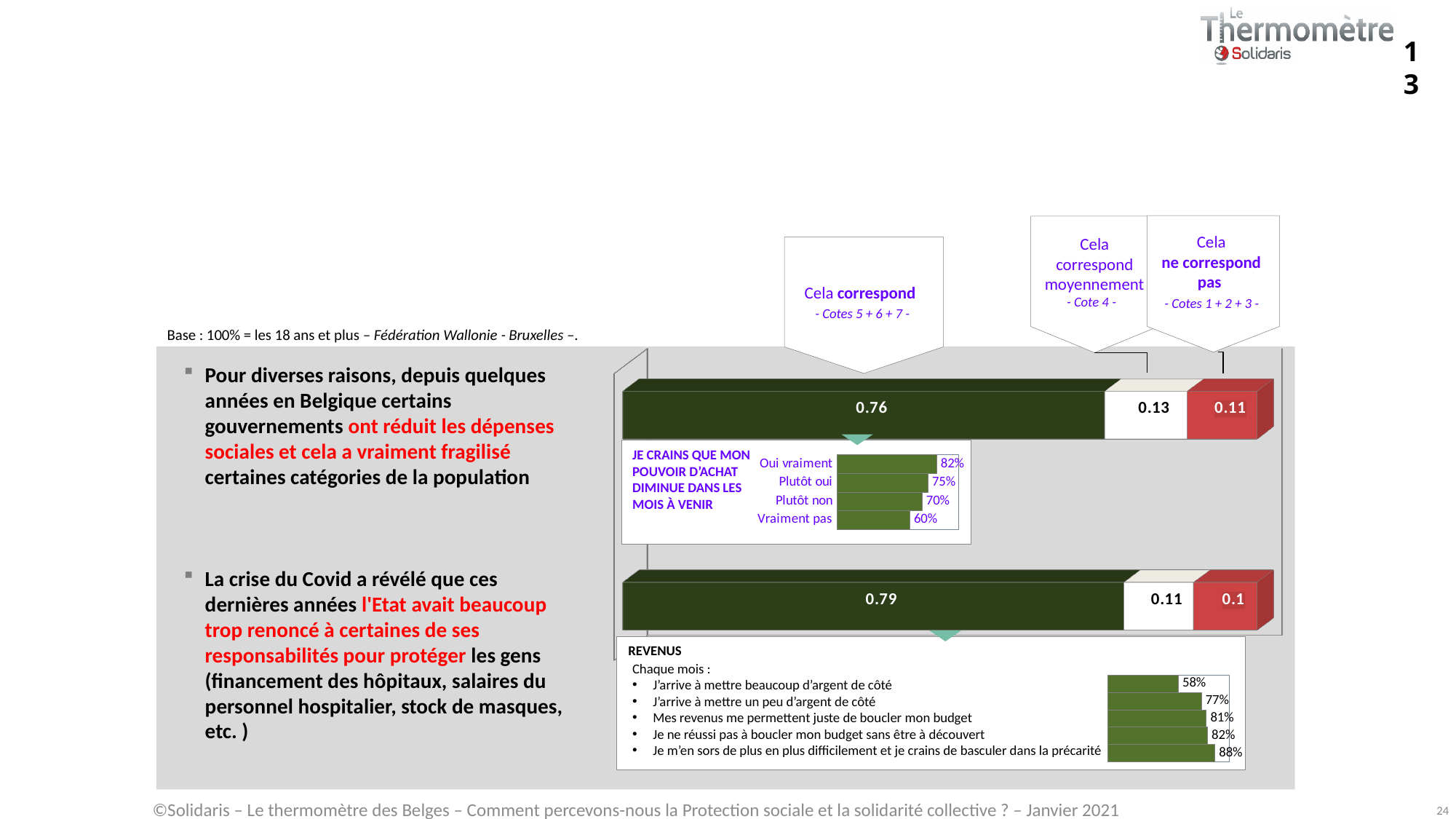
In the chart 'Je crains que mon pouvoir d'achat diminue dans les mois à venir', what is the difference between 'Oui vraiment' and 'Vraiment pas'? 22 percentage points How many categories are shown in the 'Revenus' chart? 5 In the chart 'Je crains que mon pouvoir d'achat diminue dans les mois à venir', what is the value for 'Oui vraiment'? 82% Which stacked bar has the larger 'Cela correspond' value, the top one or the bottom one? the bottom one What is the total of the three segments in the top stacked bar? 1 In the top stacked bar, what is the value for 'Cela ne correspond pas'? 0.11 In the top stacked bar (next to the statement about governments reducing social spending), what is the value for 'Cela correspond'? 0.76 In the bottom stacked bar (next to the statement about the Covid crisis), what is the value for 'Cela correspond moyennement'? 0.11 In the 'Revenus' chart, what is the value for 'J'arrive à mettre beaucoup d'argent de côté'? 58% In the bottom stacked bar, what is the value for 'Cela correspond'? 0.79 In the chart 'Je crains que mon pouvoir d'achat diminue dans les mois à venir', which category has the lowest value? Vraiment pas In the 'Revenus' chart, which category has the highest value? Je m'en sors de plus en plus difficilement et je crains de basculer dans la précarité